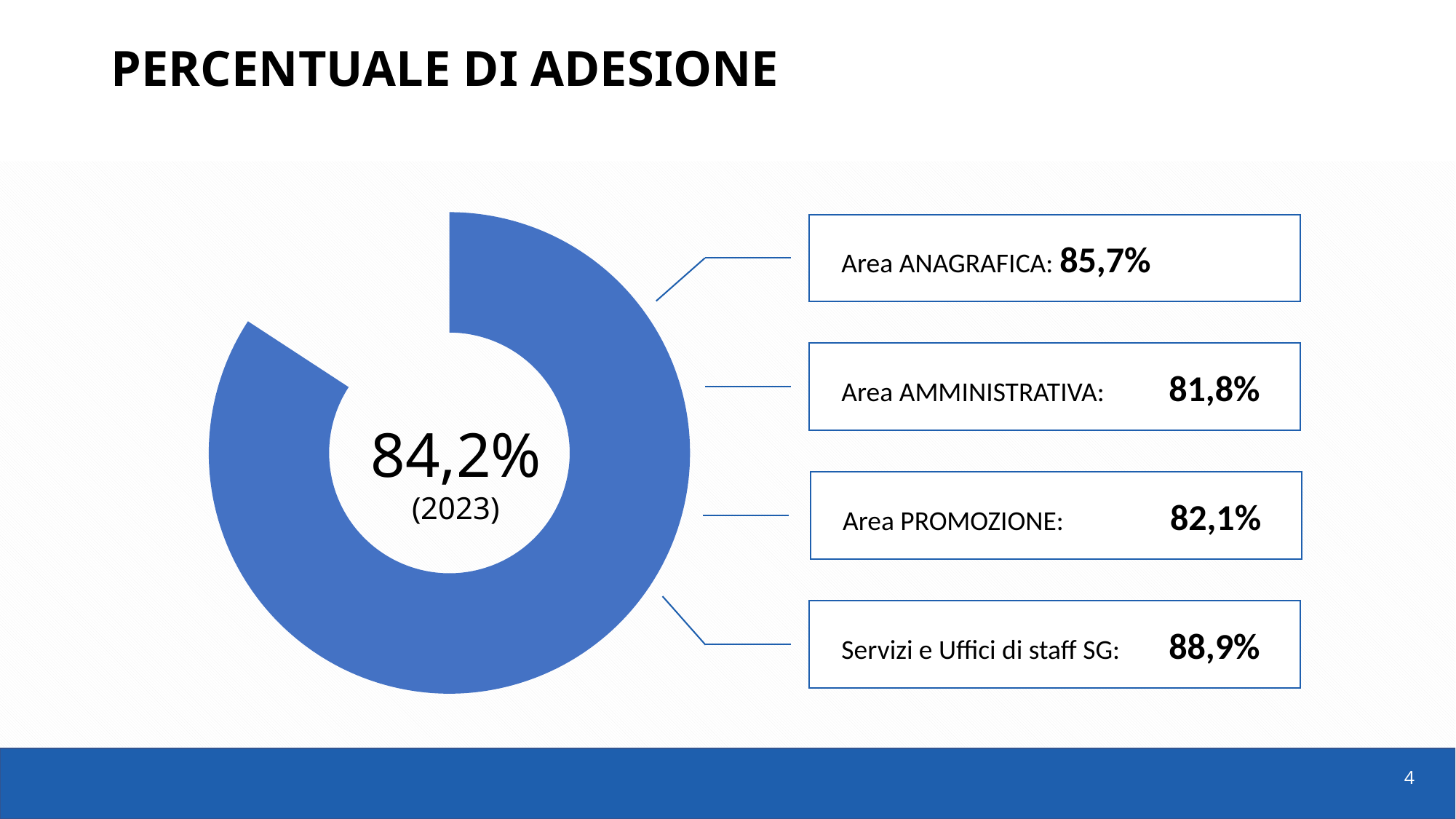
What kind of chart is shown on the slide? Doughnut chart What is the adhesion percentage for Servizi e Uffici di staff SG? 88,9% What is the adhesion percentage for Area AMMINISTRATIVA? 81,8% Which has a higher adhesion percentage, Area ANAGRAFICA or Area PROMOZIONE? Area ANAGRAFICA Which year is indicated in the centre of the doughnut chart? 2023 What percentage is shown in the centre of the doughnut chart? 84,2% Which area has the lowest adhesion percentage? Area AMMINISTRATIVA How many areas are listed next to the doughnut chart? 4 What is the difference between the adhesion percentage of Servizi e Uffici di staff SG and Area AMMINISTRATIVA? 7,1% What is the adhesion percentage for Area PROMOZIONE? 82,1% What is the adhesion percentage for Area ANAGRAFICA? 85,7% Which area has the highest adhesion percentage? Servizi e Uffici di staff SG